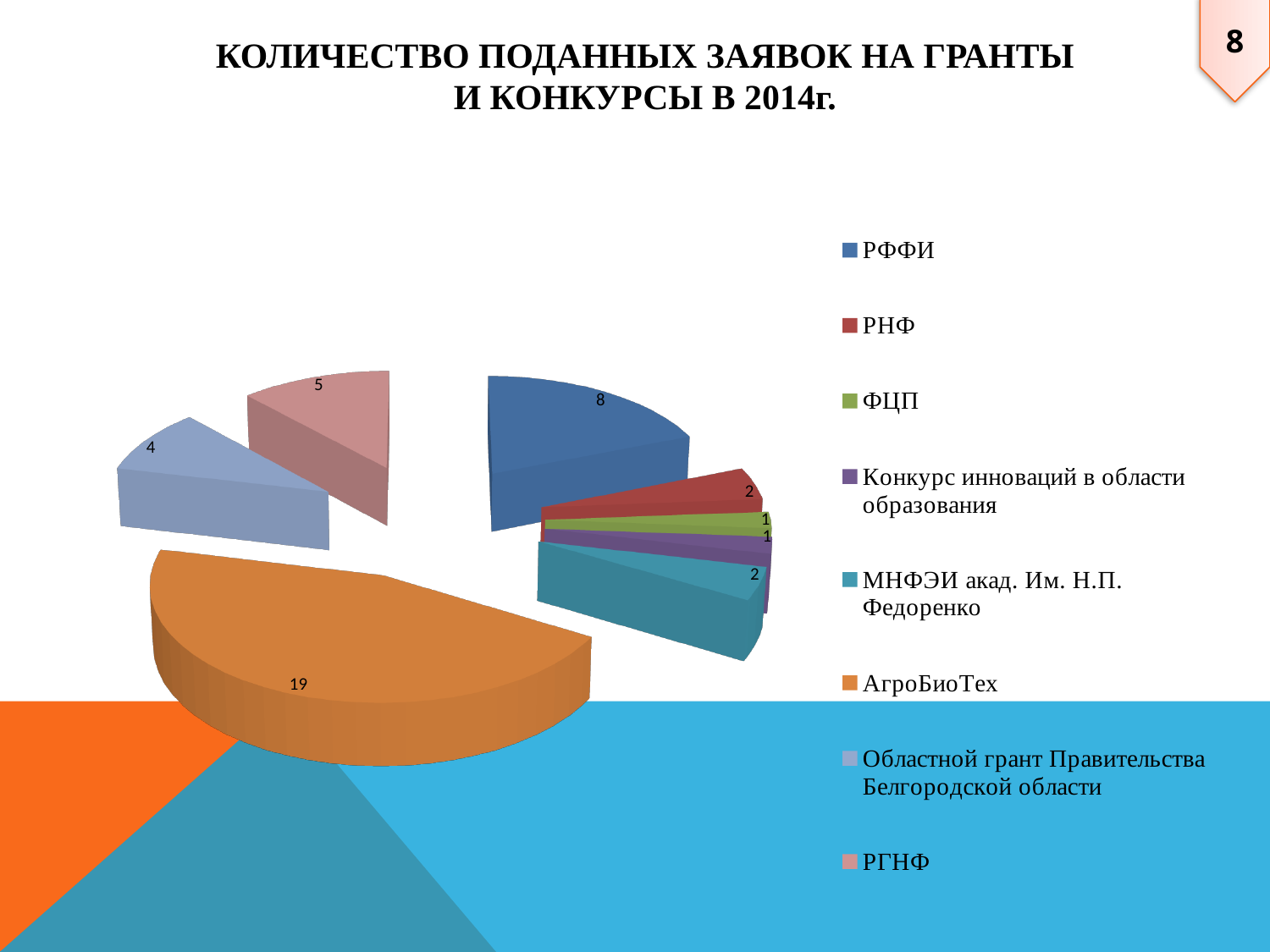
What is the value for Областной грант Правительства Белгородской области? 4 How many categories (slices) does the pie chart have? 8 What is the value for МНФЭИ акад. Им. Н.П. Федоренко? 2 What is the difference between the values for АгроБиоТех and РФФИ? 11 Which categories have the smallest value on the chart? ФЦП and Конкурс инноваций в области образования Which is larger, the value for РГНФ or the value for РНФ? РГНФ Which category has the largest number of submitted applications? АгроБиоТех How many applications were submitted to РФФИ? 8 How many applications were submitted to РГНФ? 5 How many applications were submitted to АгроБиоТех? 19 What is the title of the chart on the slide? КОЛИЧЕСТВО ПОДАННЫХ ЗАЯВОК НА ГРАНТЫ И КОНКУРСЫ В 2014г. What kind of chart is shown on the slide? Pie chart